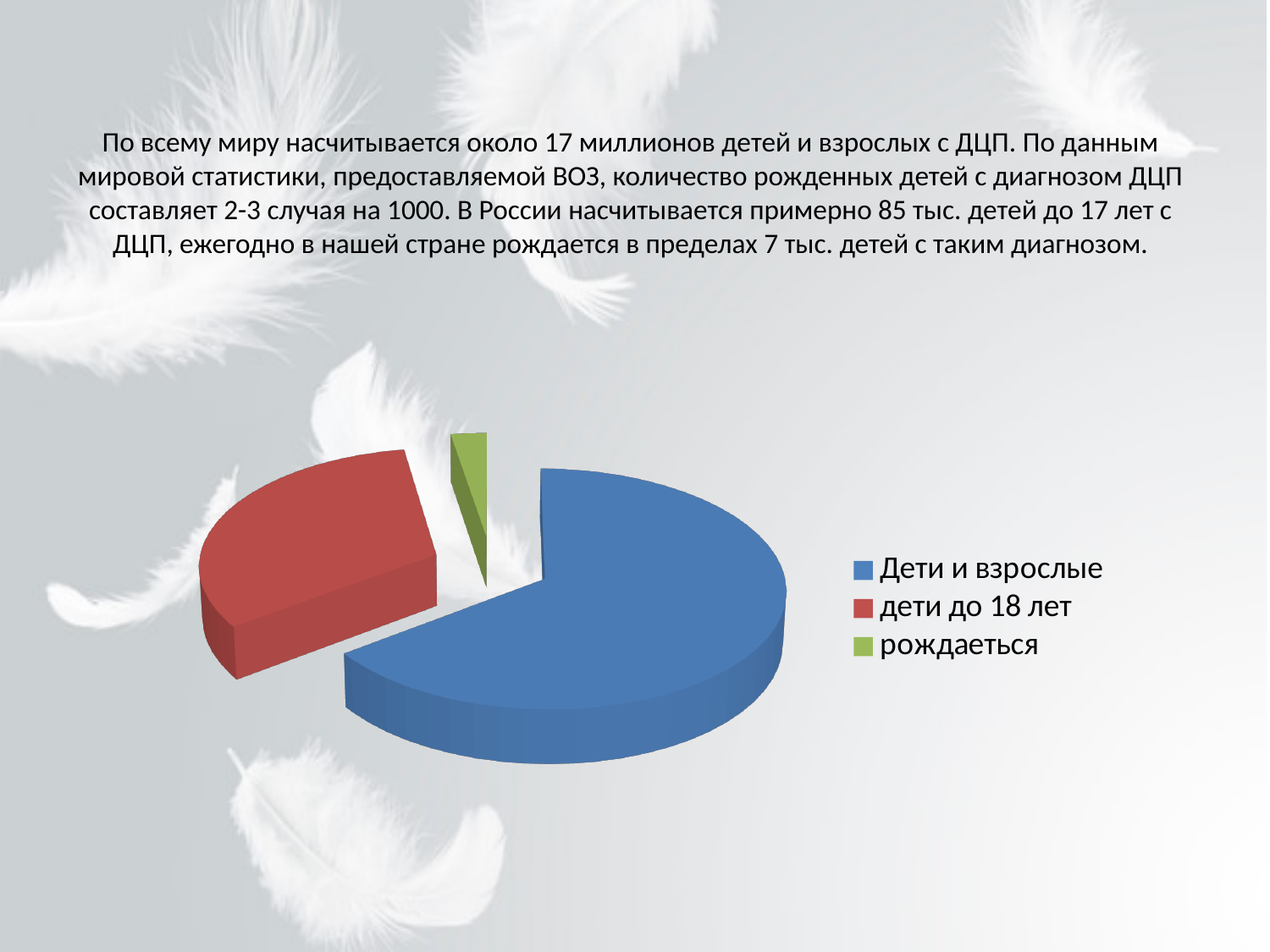
How many slices does the pie chart have? 3 Which slice is larger: "Дети и взрослые" or "дети до 18 лет"? Дети и взрослые What kind of chart is shown on the slide? pie chart Which category has the largest slice in the pie chart? Дети и взрослые Which slice is larger: "дети до 18 лет" or "рождаеться"? дети до 18 лет Which category is shown in green in the pie chart? рождаеться What colour is the slice for "дети до 18 лет" in the pie chart? red How many entries does the legend of the pie chart list? 3 Which category has the smallest slice in the pie chart? рождаеться